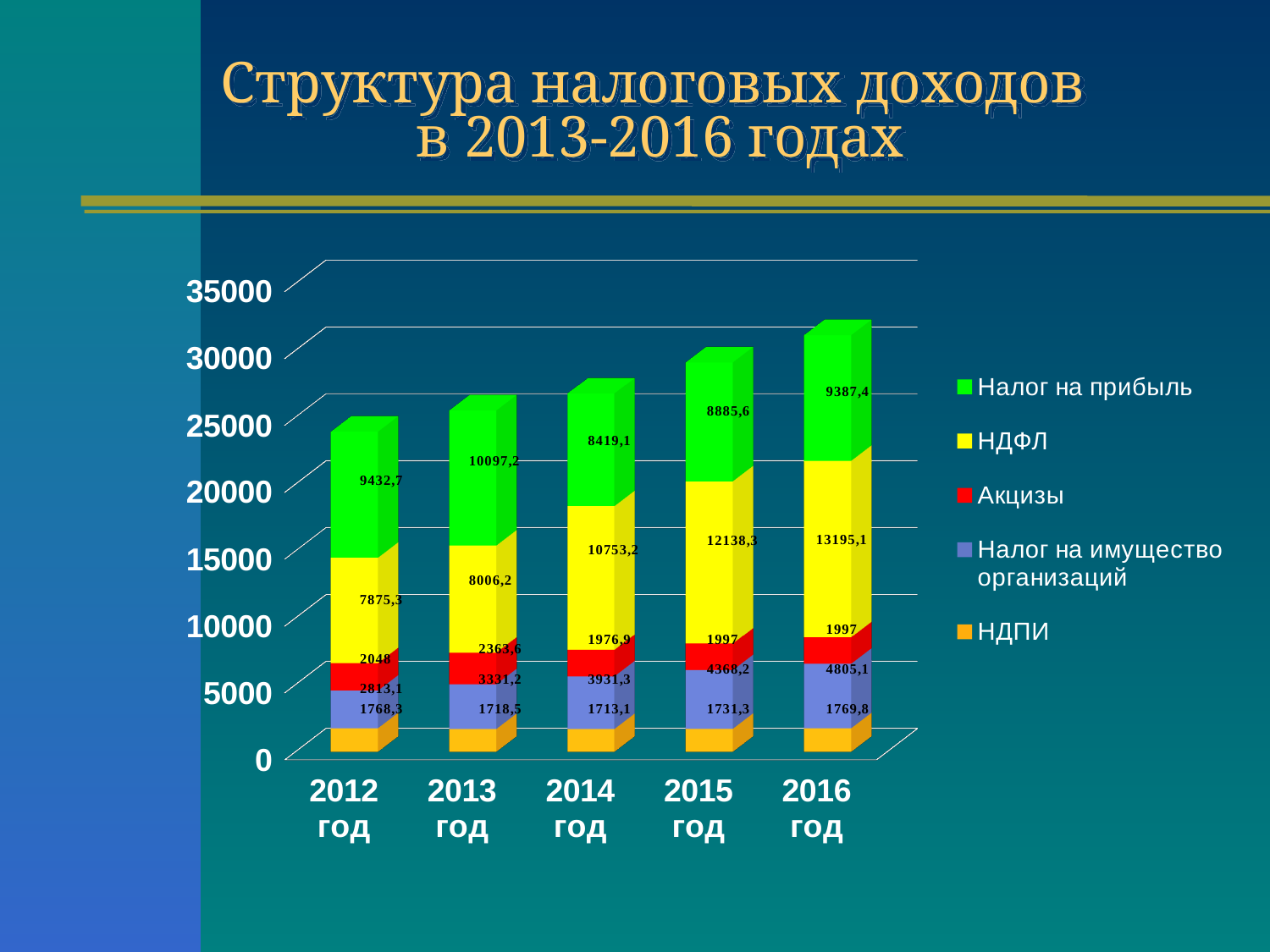
What is the difference between НДФЛ in 2016 год and НДФЛ in 2012 год? 5319,8 How many years (categories) are shown on the x axis? 5 What is the value of Налог на прибыль for 2013 год? 10097,2 What type of chart is shown on the slide? stacked bar chart Which colour represents Акцизы in the legend? red What is the value of НДФЛ for 2016 год? 13195,1 How many series does the legend list? 5 What is the value of Налог на имущество организаций for 2015 год? 4368,2 What is the total of the stacked bar for 2016 год? 31154,4 In which year is НДПИ the lowest? 2014 год In which year is Налог на прибыль the highest? 2013 год Which is larger: Акцизы in 2013 год or Акцизы in 2014 год? 2013 год